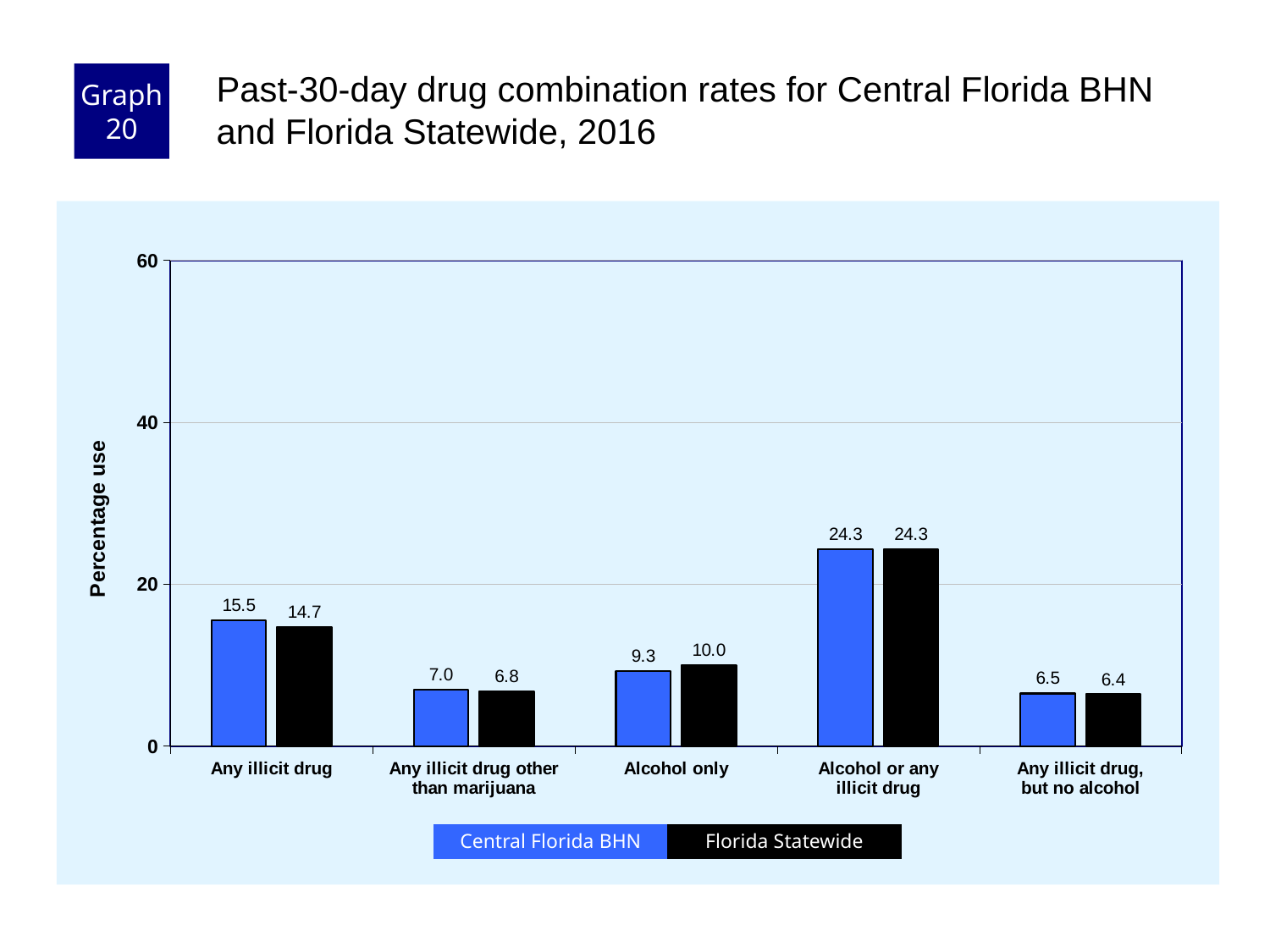
Is the Florida Statewide value for Alcohol or any illicit drug greater or less than 20? greater What is the difference between the Central Florida BHN and Florida Statewide values for Any illicit drug? 0.8 What is the Central Florida BHN value for Any illicit drug? 15.5 Which category has the lowest Florida Statewide value? Any illicit drug, but no alcohol Which is larger for Alcohol only: Central Florida BHN or Florida Statewide? Florida Statewide What kind of chart is shown on the slide? bar chart What is the Florida Statewide value for Alcohol only? 10.0 What is the label of the y axis? Percentage use Which category has the highest Central Florida BHN value? Alcohol or any illicit drug How many series does the legend list? 2 How many categories are shown on the x axis? 5 What is the Florida Statewide value for Any illicit drug other than marijuana? 6.8